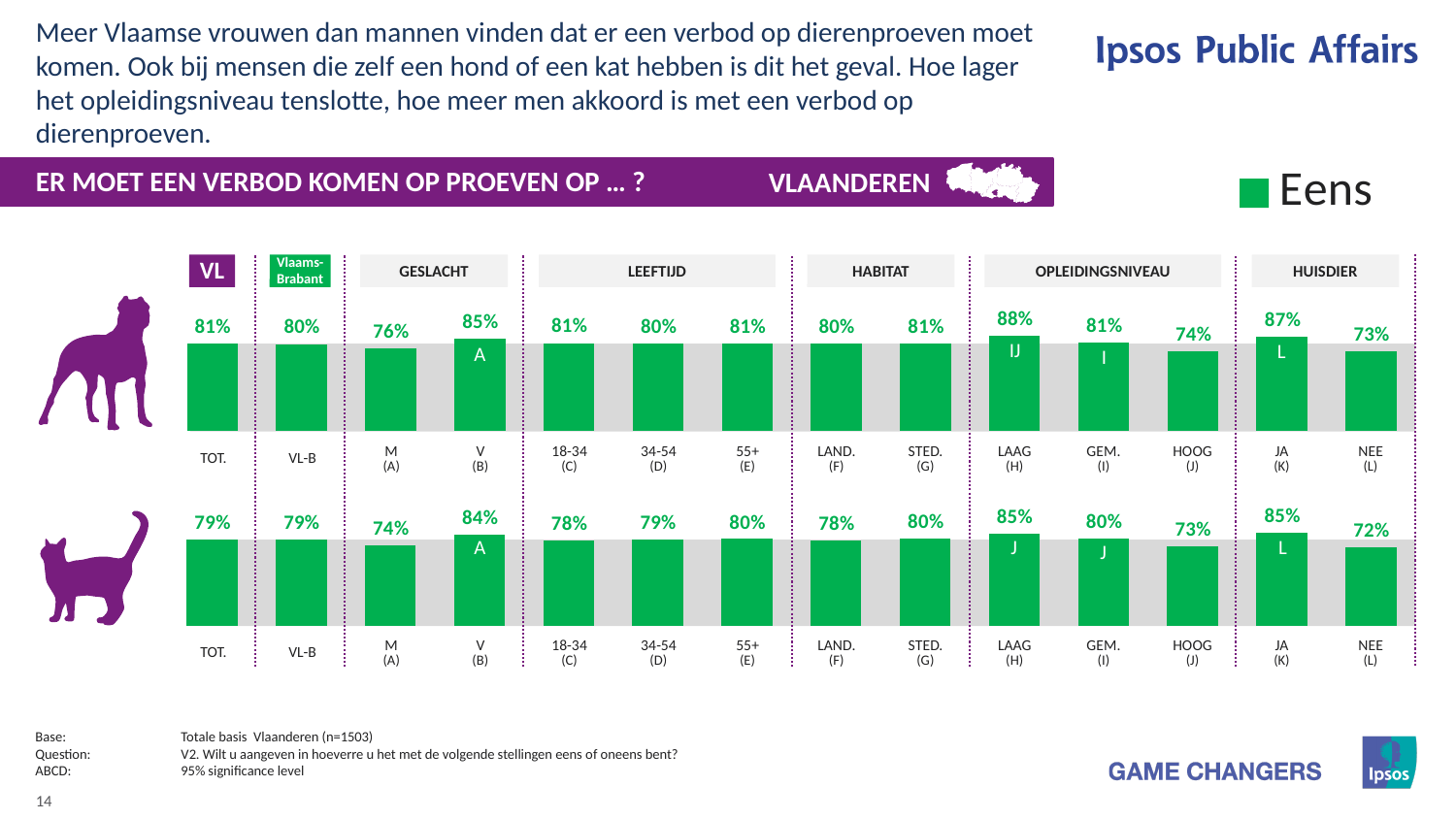
In the bottom chart (cat row), what is the difference between the values for JA (K) and NEE (L)? 13% How many bars are shown in the top chart (dog row)? 14 In the top chart (dog row), what is the difference between the values for V (B) and M (A)? 9% How many series does the legend list? 1 In the bottom chart (cat row), which is larger: the value for LAAG (H) or the value for HOOG (J)? LAAG (H) In the bottom chart (cat row), what is the value for V (B) under GESLACHT? 84% What is the legend entry shown on the slide? Eens What kind of chart is used on this slide? Bar chart In the top chart (dog row), what is the value for TOT.? 81% In the bottom chart (cat row), which category has the lowest value? NEE (L) In the top chart (dog row), which category has the highest value? LAAG (H) In the top chart (dog row), what is the value for HOOG (J) under OPLEIDINGSNIVEAU? 74%